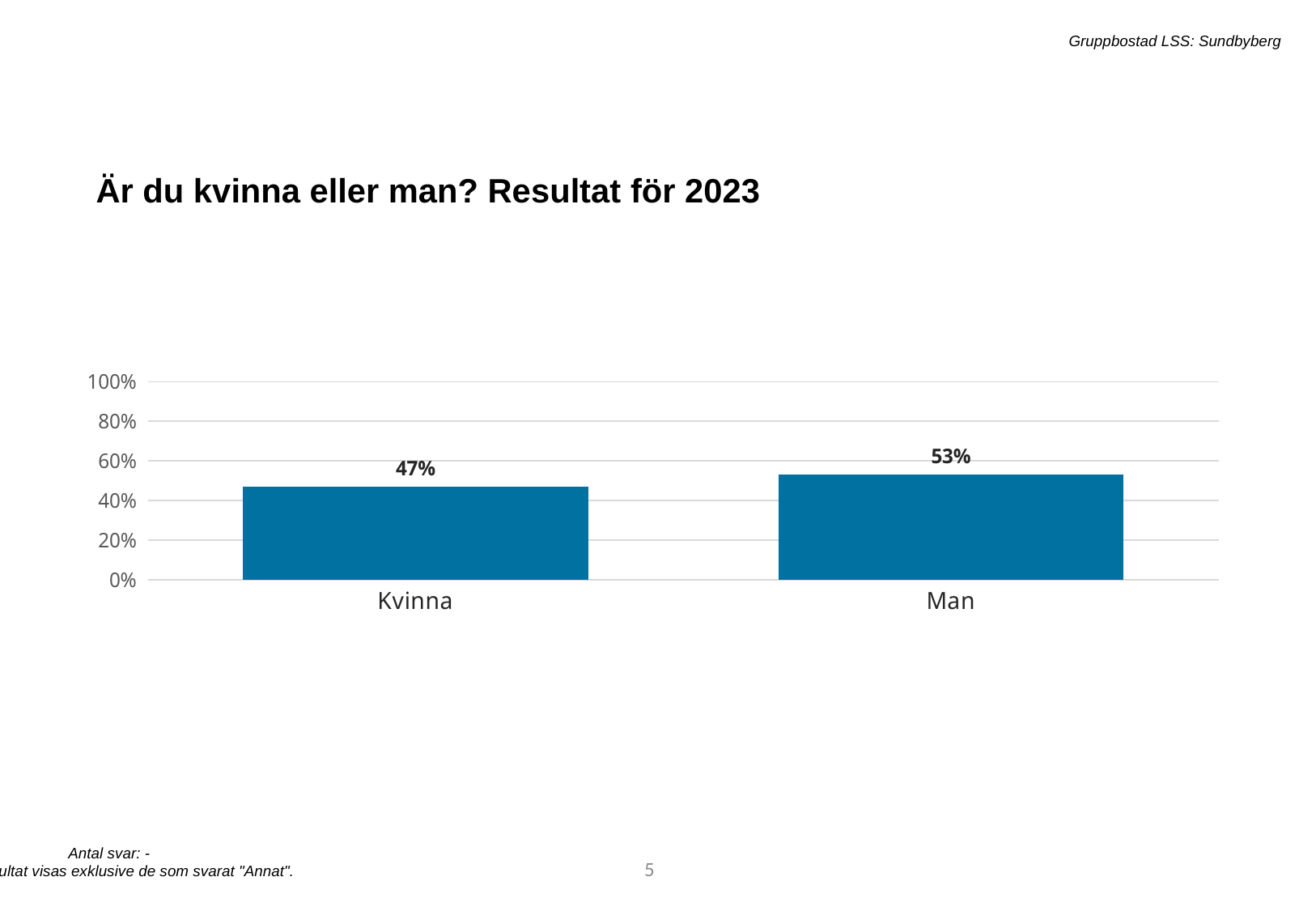
Is the value for Kvinna greater or less than 60%? less Which category has the highest value? Man What is the title of the chart? Är du kvinna eller man? Resultat för 2023 What kind of chart is shown on the slide? bar chart What is the highest tick value shown on the y axis? 100% How many categories are shown on the x axis? 2 Which category has the lowest value? Kvinna What is the value for Kvinna? 47% What is the value for Man? 53% Is the value for Man greater or less than 40%? greater Which is larger, the value for Kvinna or the value for Man? Man What is the difference between the values for Man and Kvinna? 6%